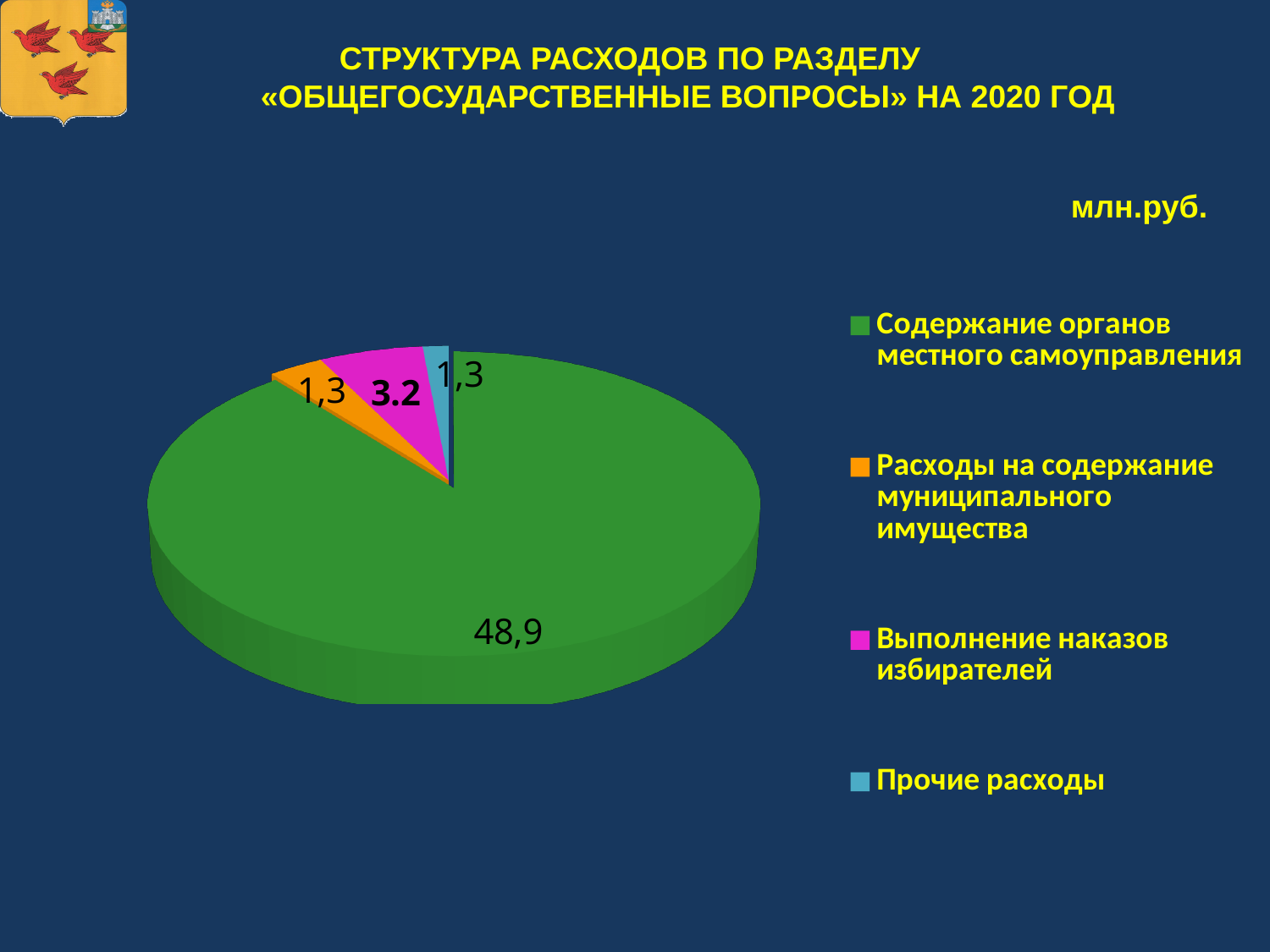
What is the difference between the values for «Содержание органов местного самоуправления» and «Выполнение наказов избирателей»? 45,7 What value is shown for the slice «Содержание органов местного самоуправления»? 48,9 What is the difference between the values for «Выполнение наказов избирателей» and «Прочие расходы»? 1,9 What value is shown for the slice «Прочие расходы»? 1,3 Which is larger: «Выполнение наказов избирателей» or «Расходы на содержание муниципального имущества»? Выполнение наказов избирателей What value is shown for the slice «Расходы на содержание муниципального имущества»? 1,3 Which category has the largest slice of the pie? Содержание органов местного самоуправления How many slices does the pie chart have? 4 What value is shown for the slice «Выполнение наказов избирателей»? 3.2 What kind of chart is shown on the slide? Pie chart What unit of measurement is indicated for the chart values? млн.руб. How many entries does the legend list? 4